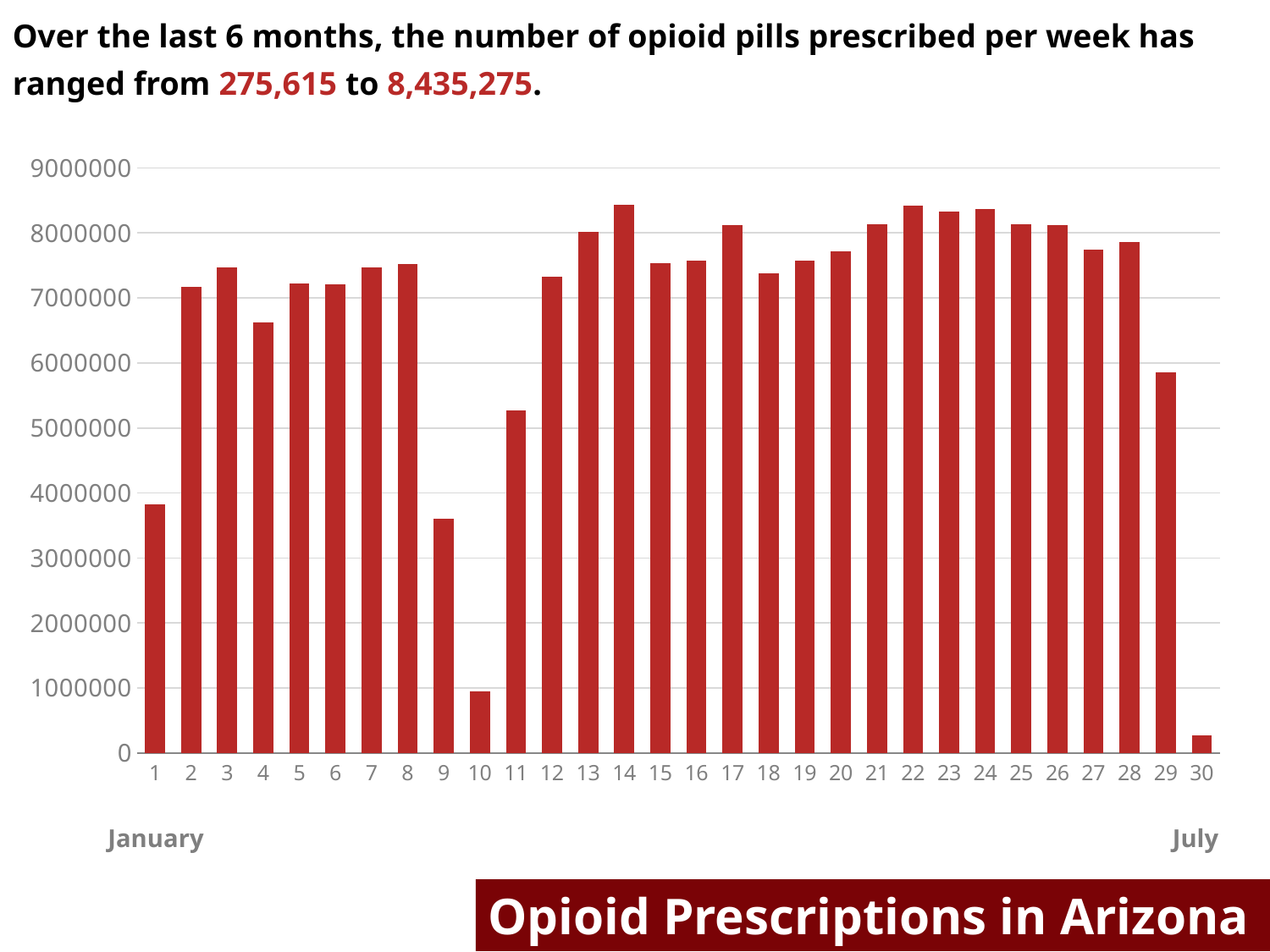
Which week has the larger value, week 29 or week 28? 28 What is the highest weekly number of opioid pills prescribed, as stated on the slide? 8,435,275 Which week has the highest number of opioid pills prescribed? 14 How many weeks (bars) are plotted on the chart? 30 Is the value for week 11 greater or less than 6000000? less Is the value for week 9 greater or less than 3000000? greater What is the title shown in the banner at the bottom of the slide? Opioid Prescriptions in Arizona Which week has the lowest number of opioid pills prescribed? 30 What is the lowest weekly number of opioid pills prescribed, as stated on the slide? 275,615 What kind of chart is shown on the slide? bar chart Which week has the larger value, week 1 or week 2? 2